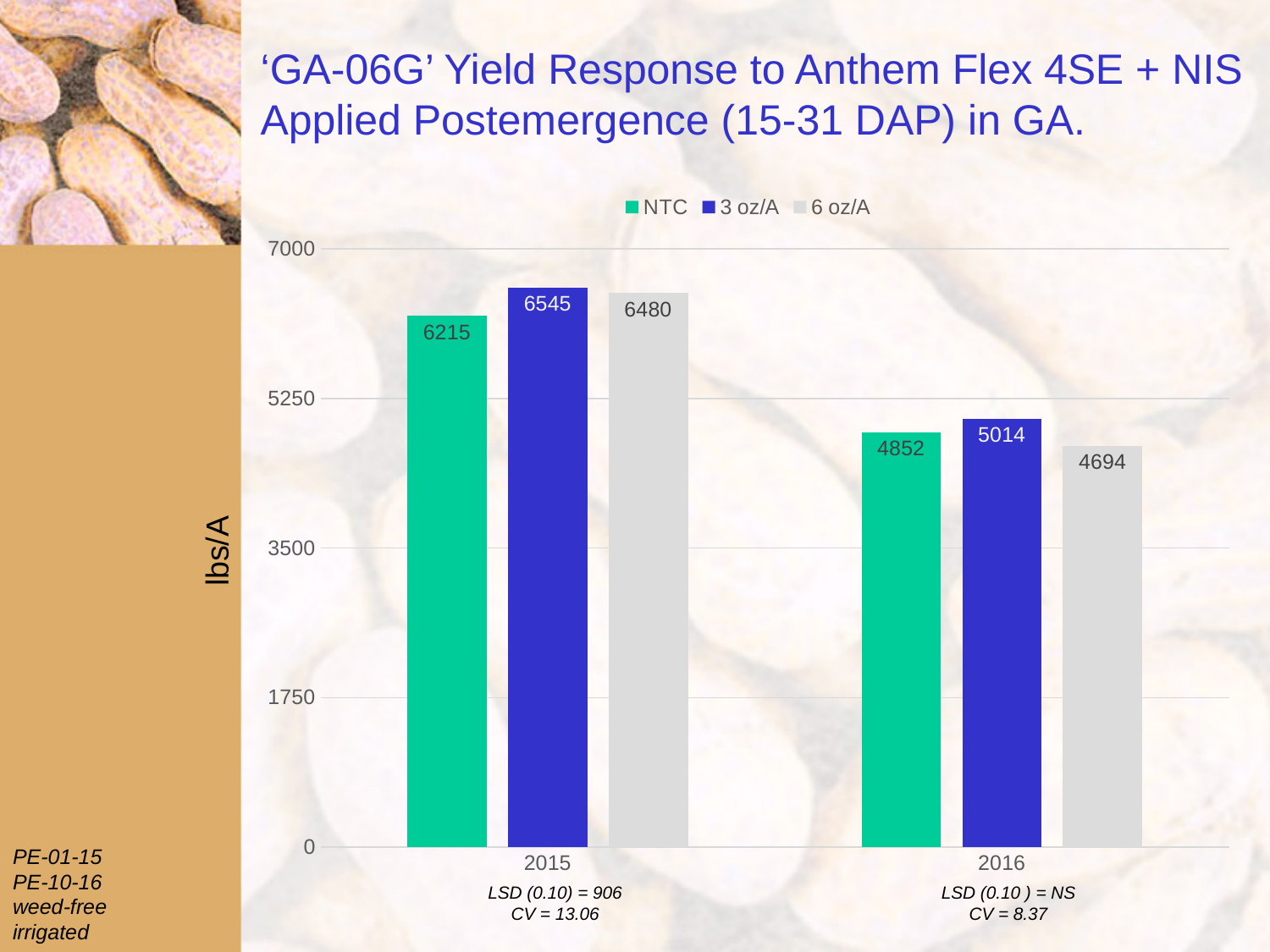
What kind of chart is shown on the slide? bar chart How many series does the legend list? 3 What is the yield for 6 oz/A in 2015? 6480 What is the difference between the 3 oz/A and NTC yields in 2015? 330 Which treatment had the highest yield in 2015? 3 oz/A What is the yield for 3 oz/A in 2016? 5014 What is the label on the vertical axis? lbs/A What is the yield for NTC in 2015? 6215 Which is larger, the 6 oz/A yield in 2015 or the 6 oz/A yield in 2016? 2015 Which treatment had the lowest yield in 2016? 6 oz/A What is the difference between the NTC yields in 2015 and 2016? 1363 Is the NTC yield in 2016 greater or less than 5250? less